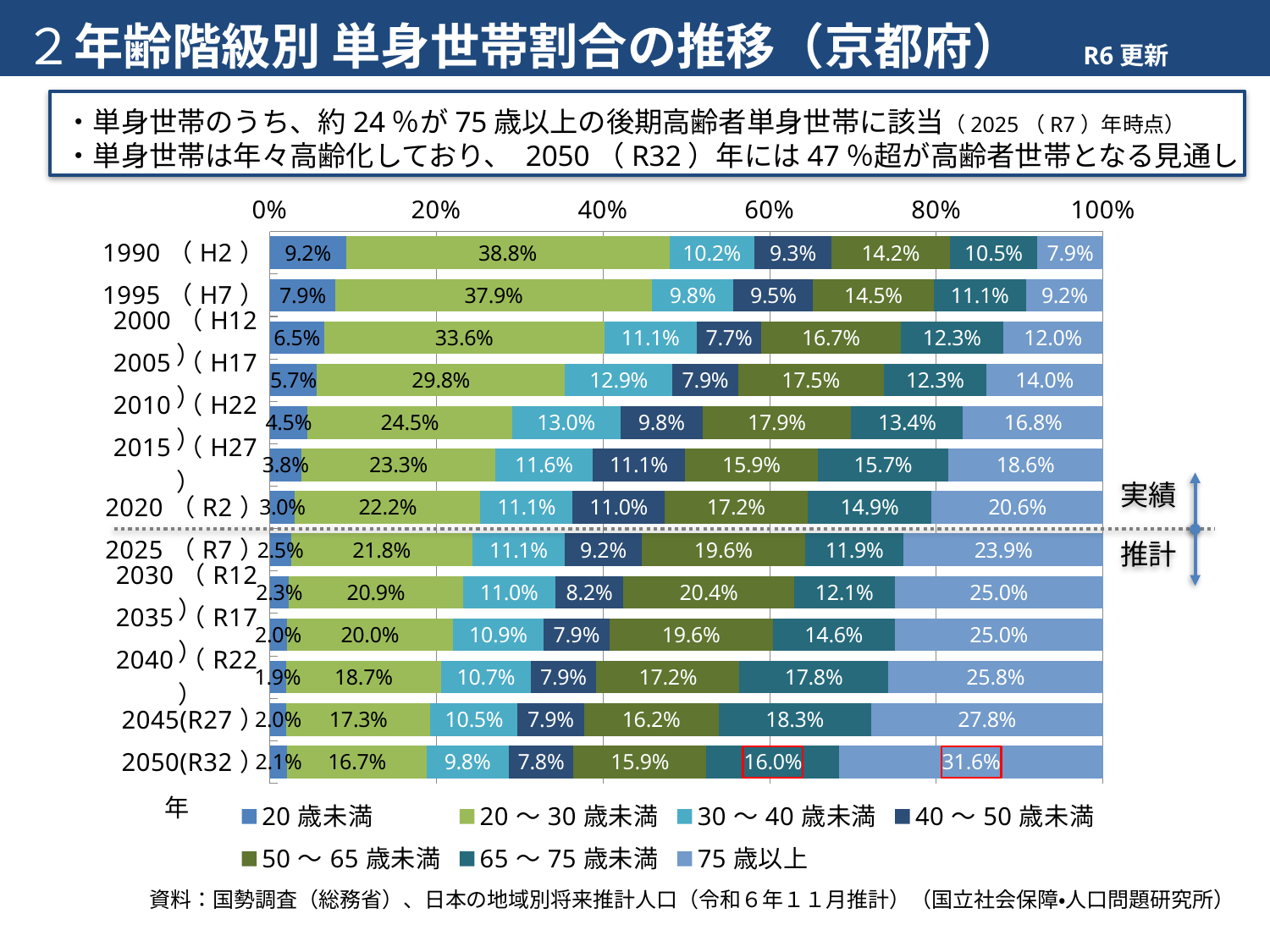
「20歳未満」の割合が最も高いのはどの年ですか？ 1990（H2）年 2050（R32）年の「75歳以上」の割合はいくらですか？ 31.6% 凡例にはいくつの年齢階級（系列）が示されていますか？ 7 2050（R32）年と1990（H2）年の「75歳以上」の割合の差はいくらですか？ 23.7ポイント このグラフはどの種類のグラフですか？ 積み上げ横棒グラフ 1990年から2050年にかけて、「20～30歳未満」の割合は増加していますか、減少していますか？ 減少 1990（H2）年の「20～30歳未満」の割合はいくらですか？ 38.8% グラフ上で「実績」と「推計」の境界はどの年の間にありますか？ 2020（R2）年と2025（R7）年の間 「75歳以上」の割合が最も高いのはどの年ですか？ 2050（R32）年 グラフには何年分（何本の棒）が示されていますか？ 13 2025（R7）年の「65～75歳未満」の割合はいくらですか？ 11.9% 2020（R2）年の「50～65歳未満」と「65～75歳未満」では、どちらの割合が大きいですか？ 50～65歳未満